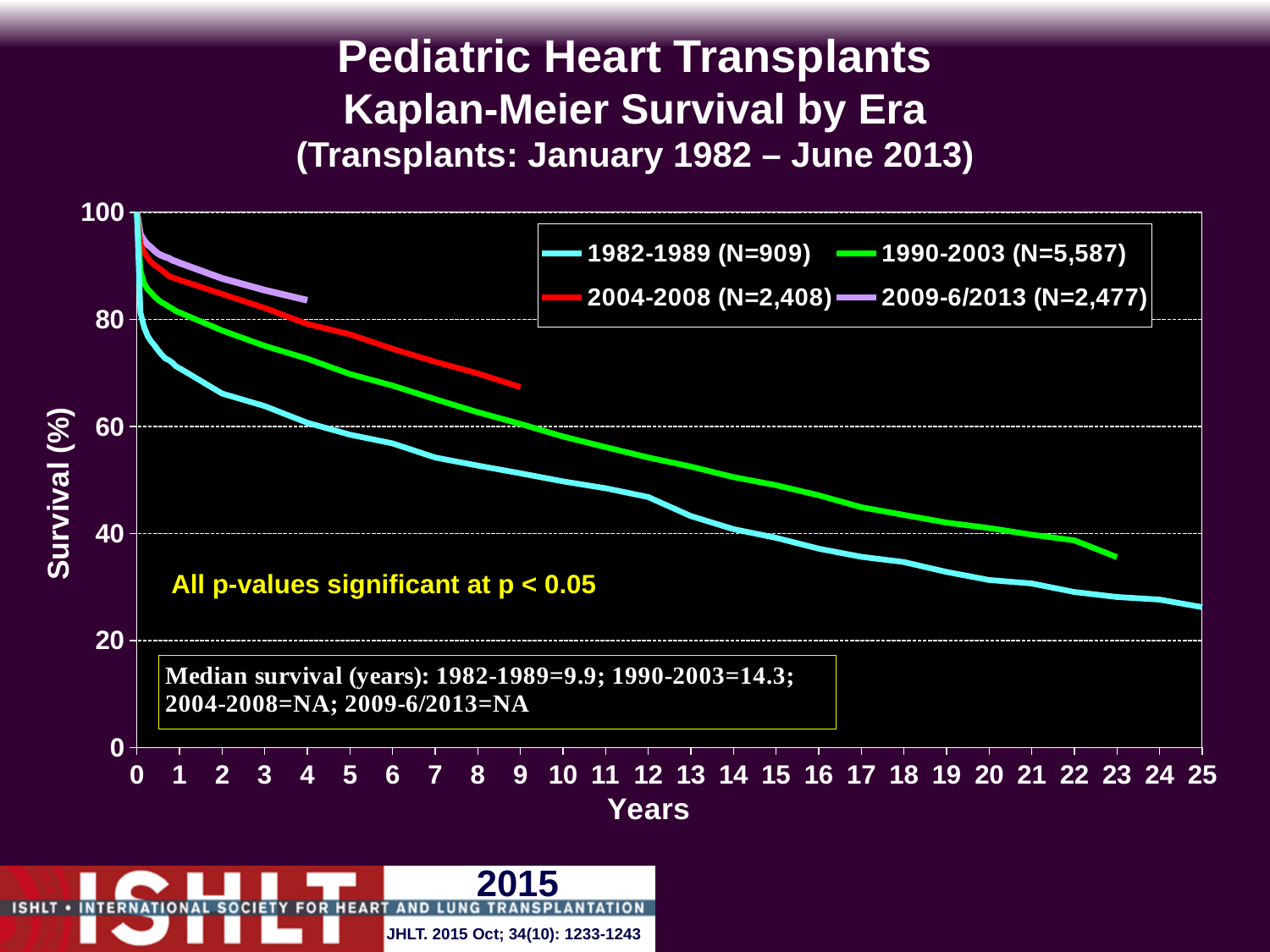
At 4 years, which era has higher survival: 2009-6/2013 or 1982-1989? 2009-6/2013 Which era has the highest survival curve on the chart? 2009-6/2013 Do the survival curves rise or fall as years increase? Fall What is the median survival in years for the 1982-1989 era? 9.9 What is the N shown in the legend for the 1990-2003 era? N=5,587 Is the survival for the 2004-2008 era at 9 years greater or less than 60? greater What is the median survival in years for the 1990-2003 era? 14.3 What is the difference in median survival (years) between the 1990-2003 era and the 1982-1989 era? 4.4 How many series (eras) does the legend list? 4 Is the survival for the 2009-6/2013 era at 4 years greater or less than 80? greater Is the survival for the 1982-1989 era at 25 years greater or less than 40? less What kind of chart is shown on the slide? Line chart